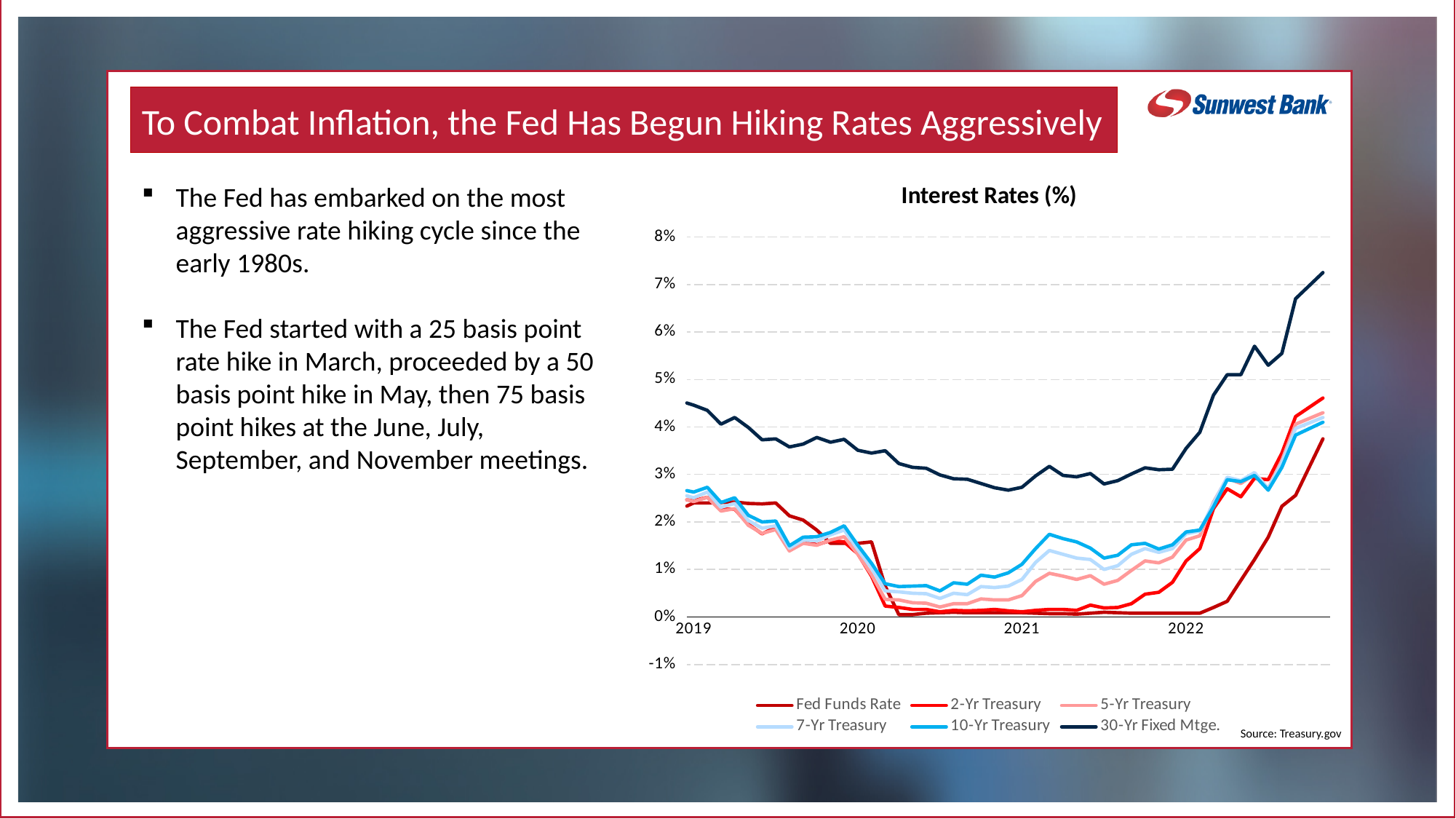
What is the title of the chart on the slide? Interest Rates (%) At the right end of the chart, which is higher: 30-Yr Fixed Mtge. or Fed Funds Rate? 30-Yr Fixed Mtge. Which series is the highest line across the whole chart? 30-Yr Fixed Mtge. How many year labels are shown on the x axis? 4 Is the value for 30-Yr Fixed Mtge. at the start of 2019 greater or less than 4%? greater Is the value for 30-Yr Fixed Mtge. at the right end of the chart greater or less than 7%? greater What kind of chart is shown on the slide? Line chart Is the value for Fed Funds Rate at the start of 2021 greater or less than 1%? less Which series is the lowest line at the right end of the chart? Fed Funds Rate What source is cited for the chart? Treasury.gov How many series does the legend of the Interest Rates (%) chart list? 6 Does the 30-Yr Fixed Mtge. line rise or fall from 2022 to the right end of the chart? Rise